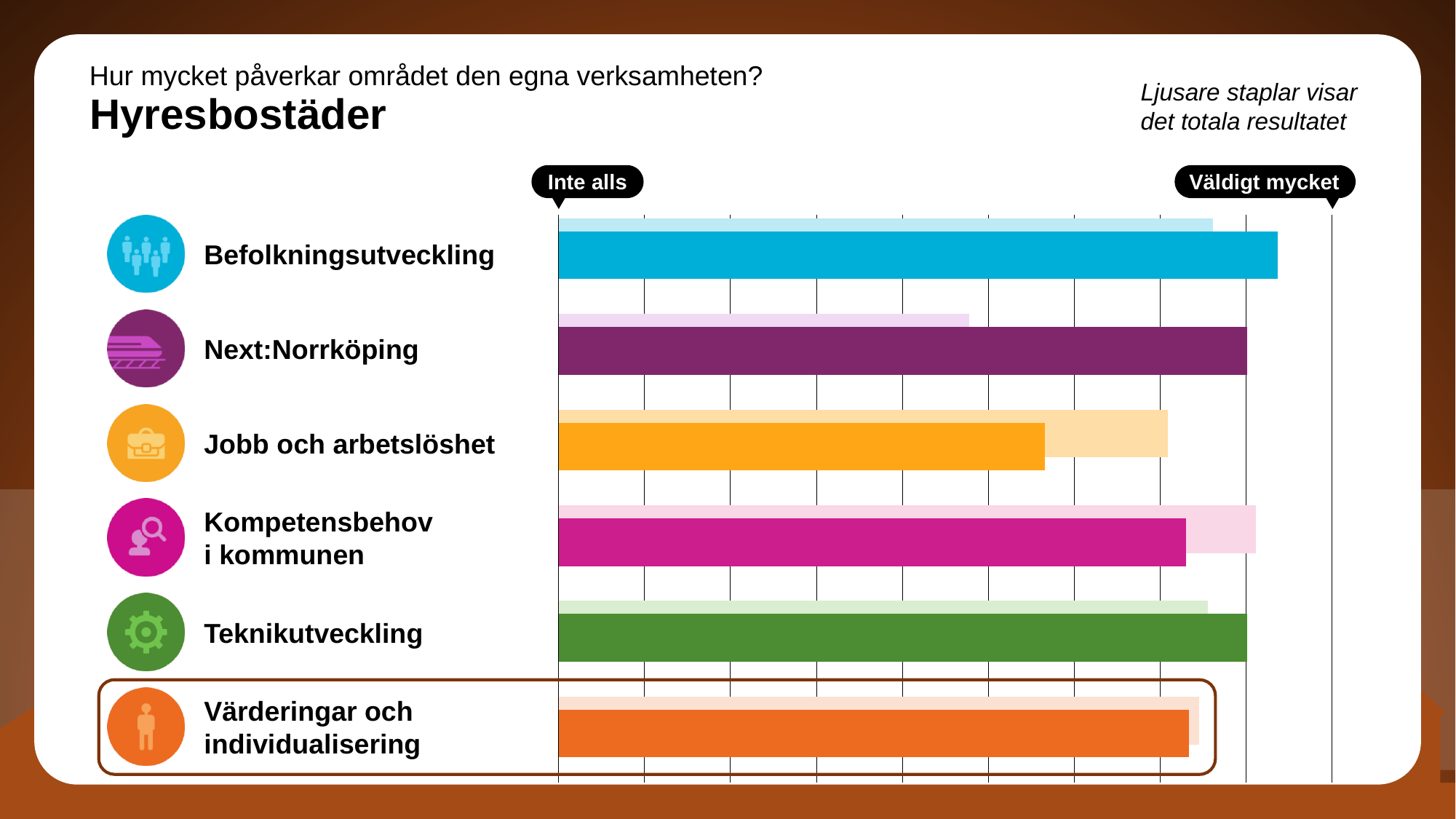
What is the main title of the chart on the slide? Hyresbostäder According to the note on the slide, what do the lighter bars show? det totala resultatet What kind of chart is shown on the slide? bar chart Which category has the shortest light (total result) bar? Next:Norrköping For Next:Norrköping, which bar is longer: the dark bar or the light bar? the dark bar Which dark bar is longer: Jobb och arbetslöshet or Kompetensbehov i kommunen? Kompetensbehov i kommunen For Jobb och arbetslöshet, which bar is longer: the dark bar or the light bar? the light bar Which category has the shortest dark (Hyresbostäder) bar? Jobb och arbetslöshet How many categories (areas) are shown in the chart? 6 Which category has the longest dark (Hyresbostäder) bar? Befolkningsutveckling Which category has the longest light (total result) bar? Kompetensbehov i kommunen How many bars are shown for each category in the chart? 2